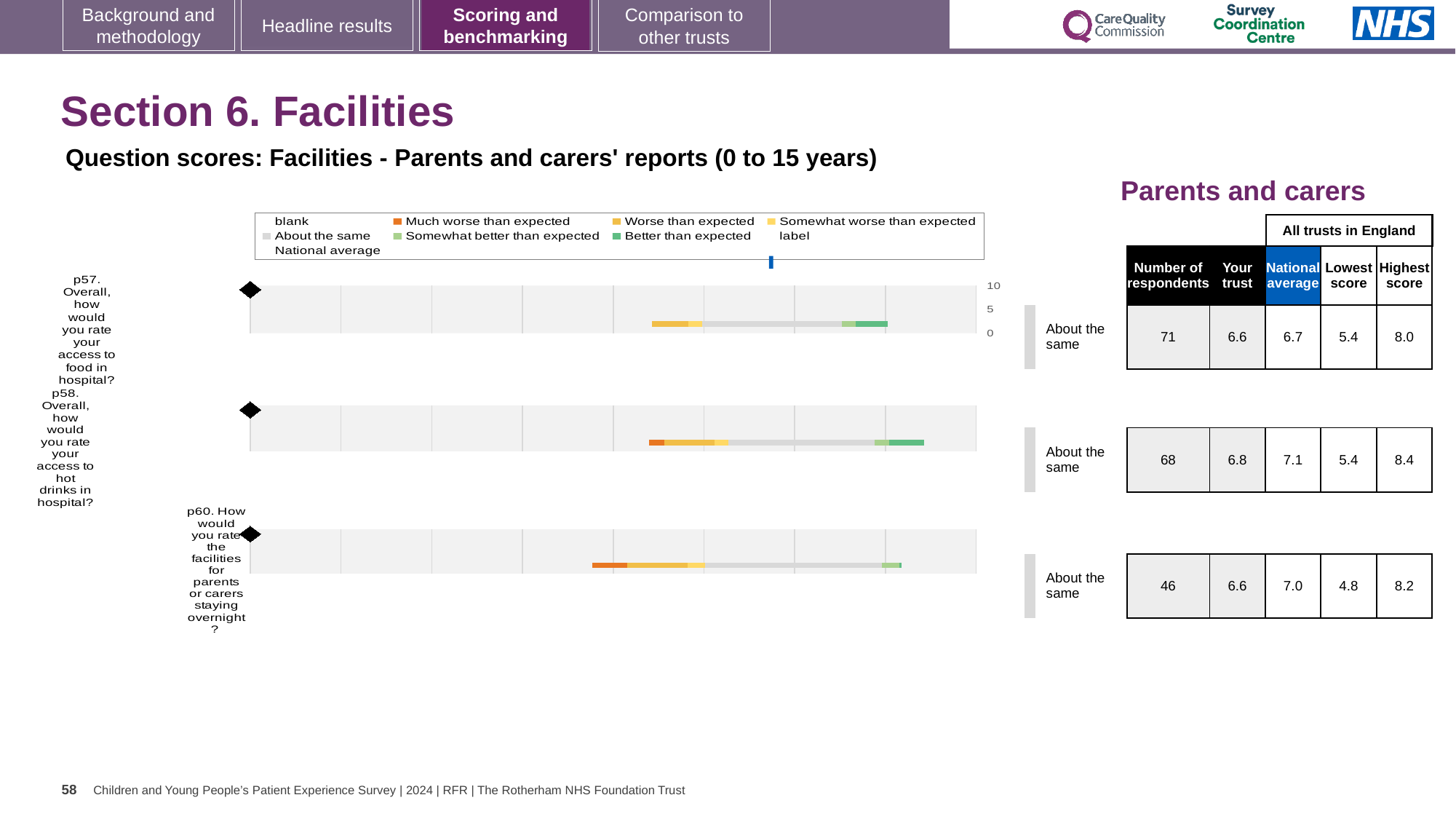
Which question has the highest 'Highest score' across all trusts in England? p58 How many more respondents answered p57 than p58? 3 What benchmark category is shown for p60? About the same What is the 'Your trust' score for p57 (access to food in hospital)? 6.6 What is the highest score among all trusts in England for p57? 8.0 How many questions (p57, p58, p60) are plotted on the slide? 3 What kind of chart is used to show the question scores on this slide? bar chart What is the national average score for p58 (access to hot drinks in hospital)? 7.1 How many respondents answered p60 (facilities for parents or carers staying overnight)? 46 Which question has the lowest 'Lowest score' across all trusts in England? p60 For p58, what is the difference between the national average and the 'Your trust' score? 0.3 For p57, which is larger: the 'Your trust' score or the national average? National average